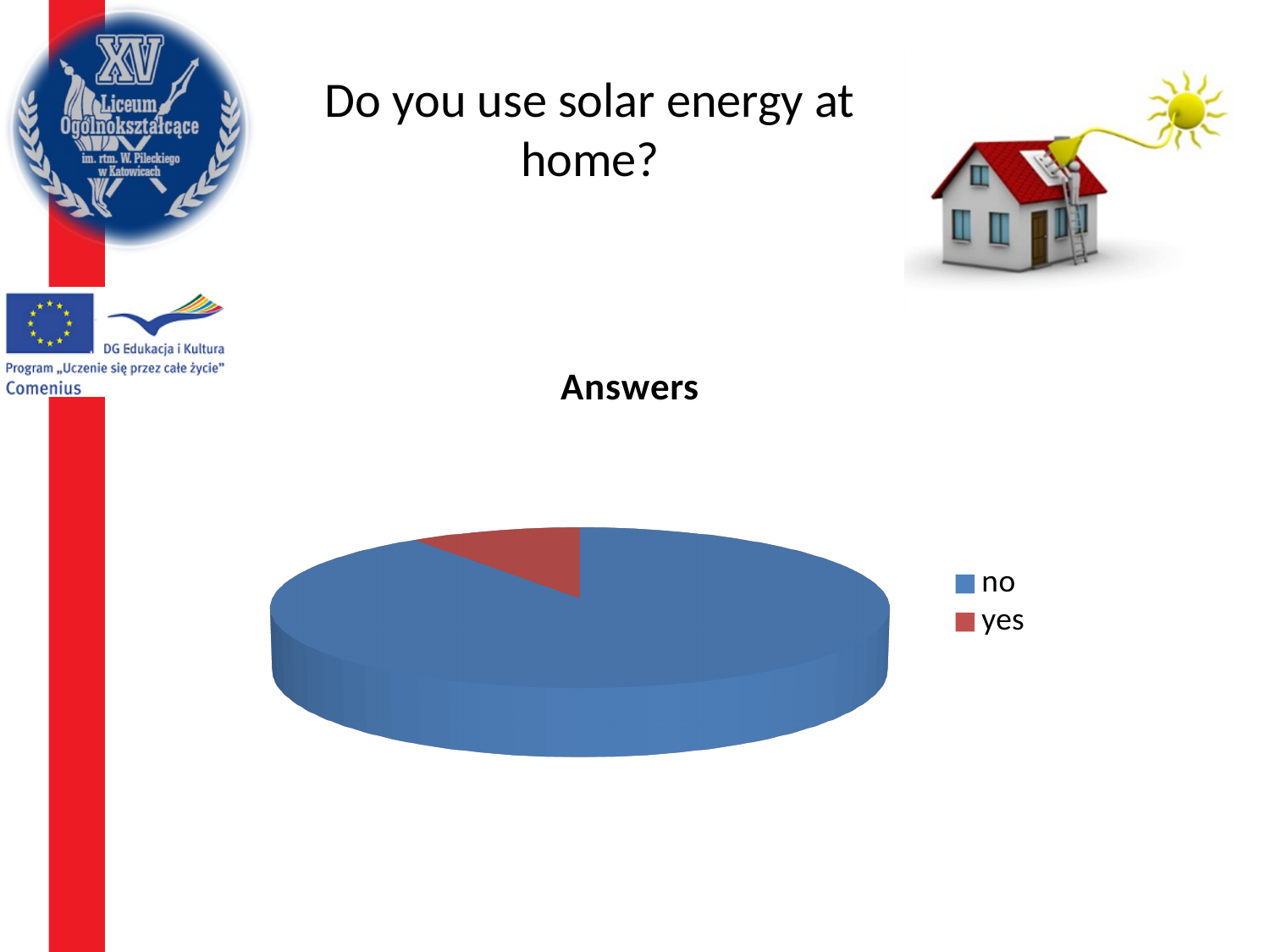
What colour is the "yes" slice in the pie chart? red What kind of chart is shown on the slide? pie chart What is the title of the chart? Answers Is the share of the "yes" slice greater or less than 50%? less Which answer has the largest slice of the pie? no Which answer has the smallest slice of the pie? yes Is the share of the "no" slice greater or less than 50%? greater Which slice is larger, "no" or "yes"? no How many slices does the pie chart have? 2 How many entries does the legend list? 2